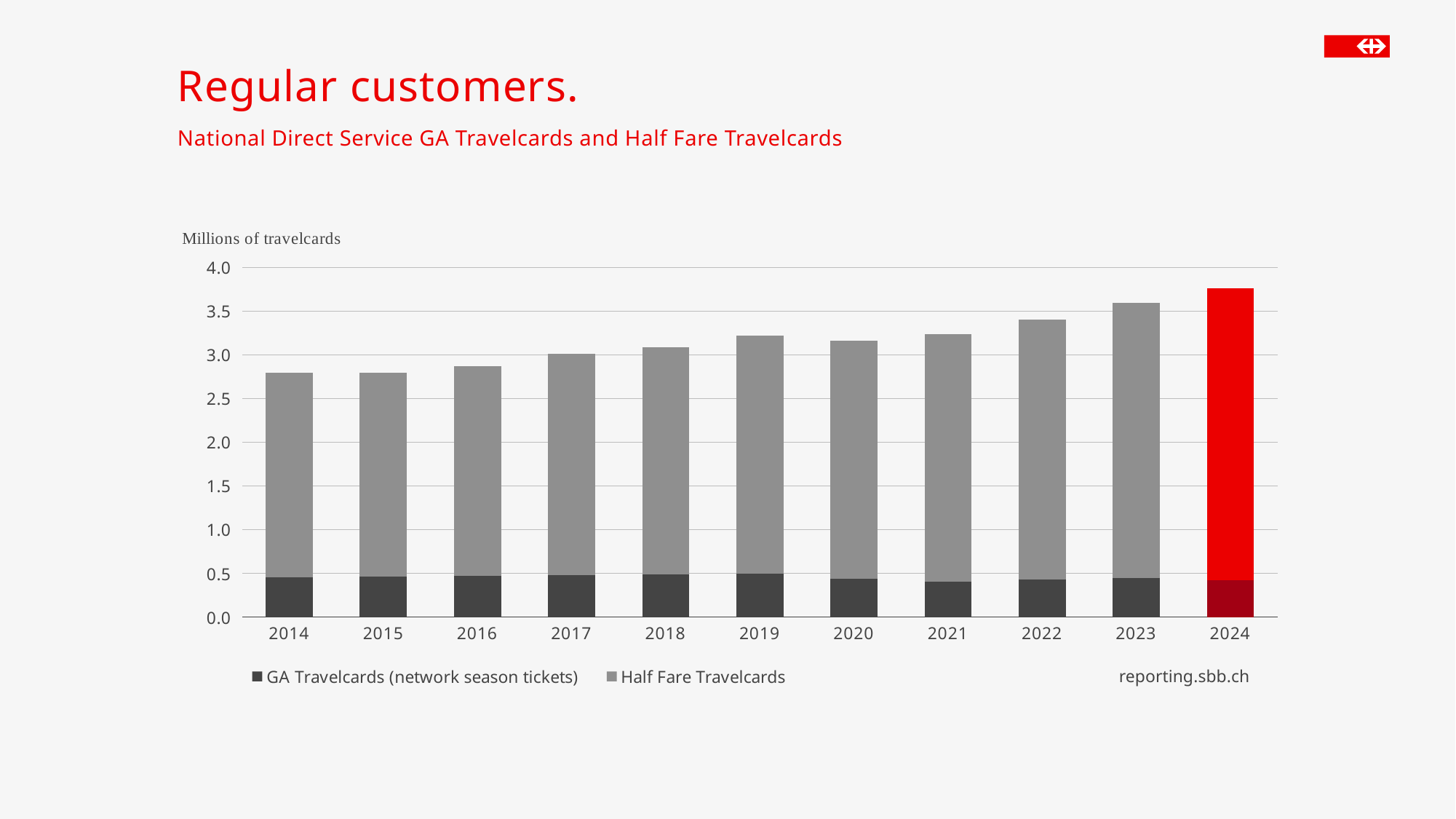
Is the value for GA Travelcards (network season tickets) in 2021 greater or less than 0.5? less How many years are shown on the x axis of the chart? 11 Which year has the highest total number of travelcards? 2024 Is the total value for 2019 greater or less than 3.0? greater Which year has the larger total number of travelcards, 2020 or 2022? 2022 How many series does the chart's legend list? 2 Do the total travelcard numbers generally rise or fall from 2014 to 2024? rise What unit is given for the y axis of the chart? Millions of travelcards Which year's bar is highlighted in red in the chart? 2024 Is the total value for 2014 greater or less than 3.0? less What kind of chart is shown on the slide? bar chart